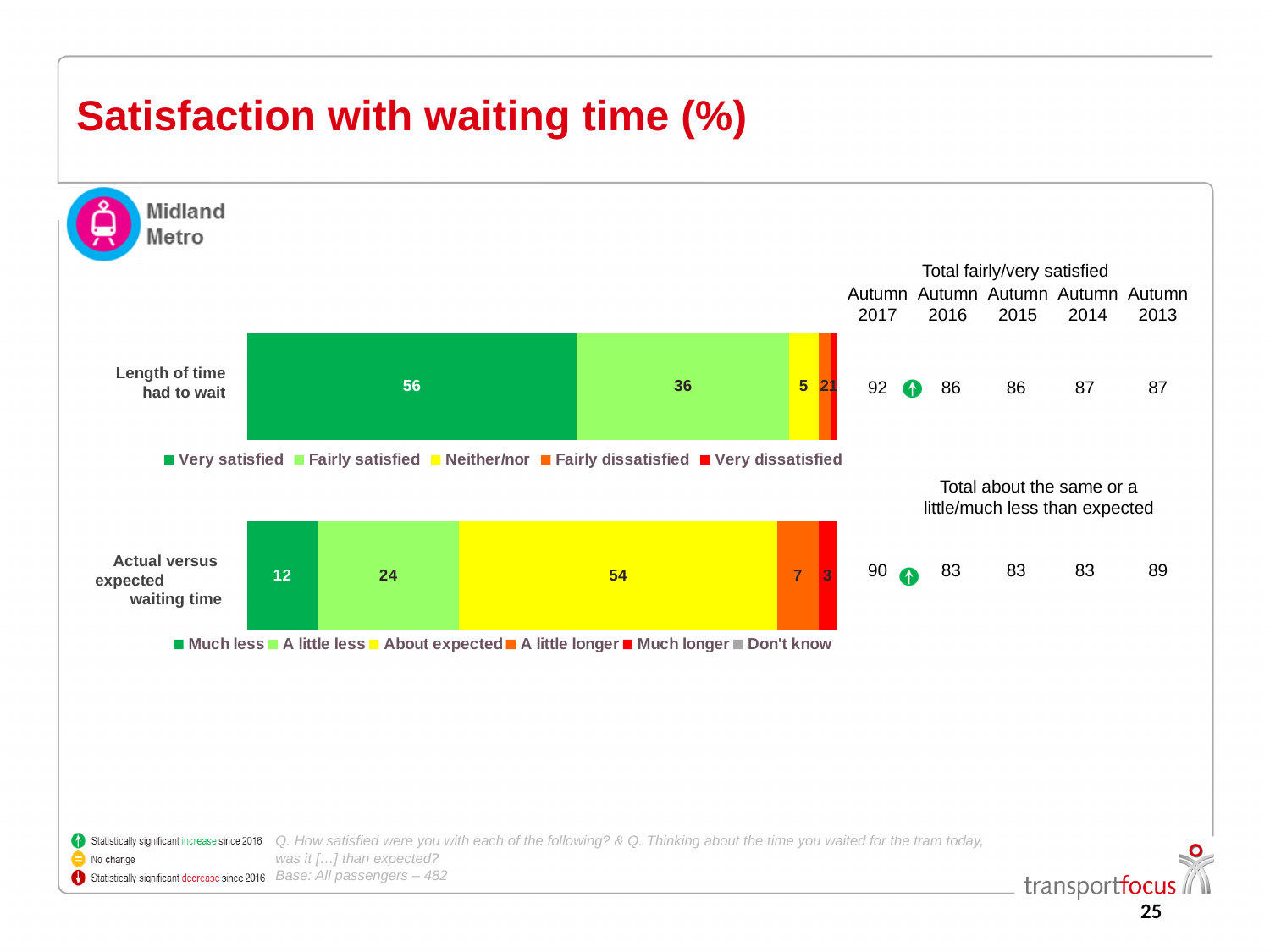
In the 'Length of time had to wait' chart, which is larger: 'Very satisfied' or 'Fairly satisfied'? Very satisfied What type of chart is used to show satisfaction with length of time had to wait? Stacked bar chart In the 'Length of time had to wait' chart, what percentage of passengers were fairly satisfied? 36 In the 'Length of time had to wait' chart, what percentage of passengers were very satisfied? 56 In the 'Length of time had to wait' chart, what is the value for 'Neither/nor'? 5 In the 'Actual versus expected waiting time' chart, what is the difference between 'A little less' and 'Much less'? 12 How many series does the legend of the 'Actual versus expected waiting time' chart list? 6 In the 'Actual versus expected waiting time' chart, which response category has the largest share? About expected What is the total fairly/very satisfied figure for length of time had to wait in Autumn 2017? 92 What is the total about the same or a little/much less than expected figure for Autumn 2013? 89 In the 'Actual versus expected waiting time' chart, what percentage said the wait was about expected? 54 In the 'Actual versus expected waiting time' chart, what is the value for 'A little longer'? 7